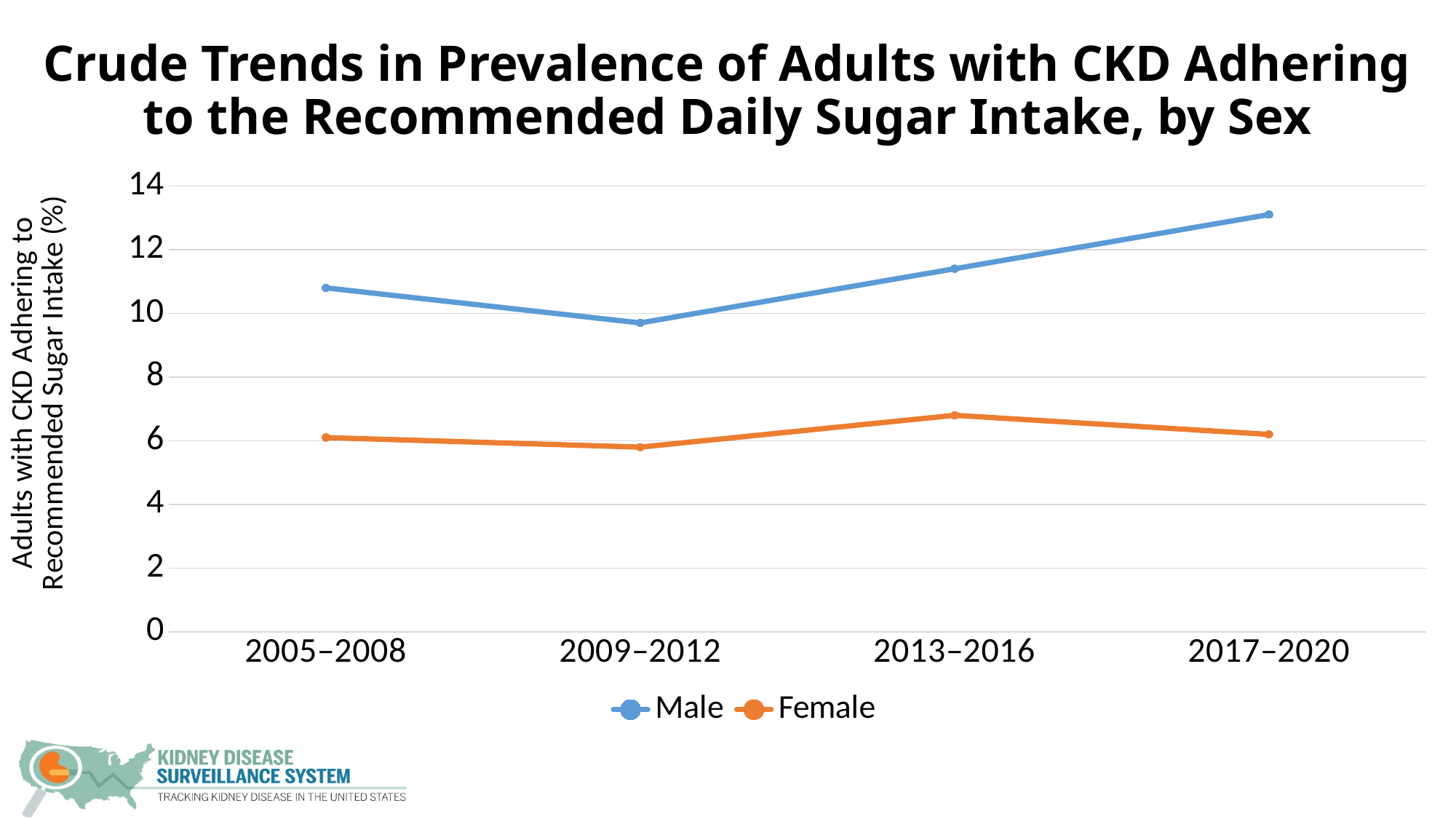
Is the Male value for 2009–2012 greater or less than 10? less Which series has the higher value in 2017–2020, Male or Female? Male Is the Male value for 2017–2020 greater or less than 12? greater In which period is the Male value highest? 2017–2020 In which period is the Female value highest? 2013–2016 How many time periods are shown on the x axis? 4 Does the Male series rise or fall from 2009–2012 to 2017–2020? rise In which period is the Male value lowest? 2009–2012 What kind of chart is shown on the slide? line chart What colour is the line for the Female series? orange How many series does the legend list? 2 Is the Female value for 2013–2016 greater or less than 6? greater